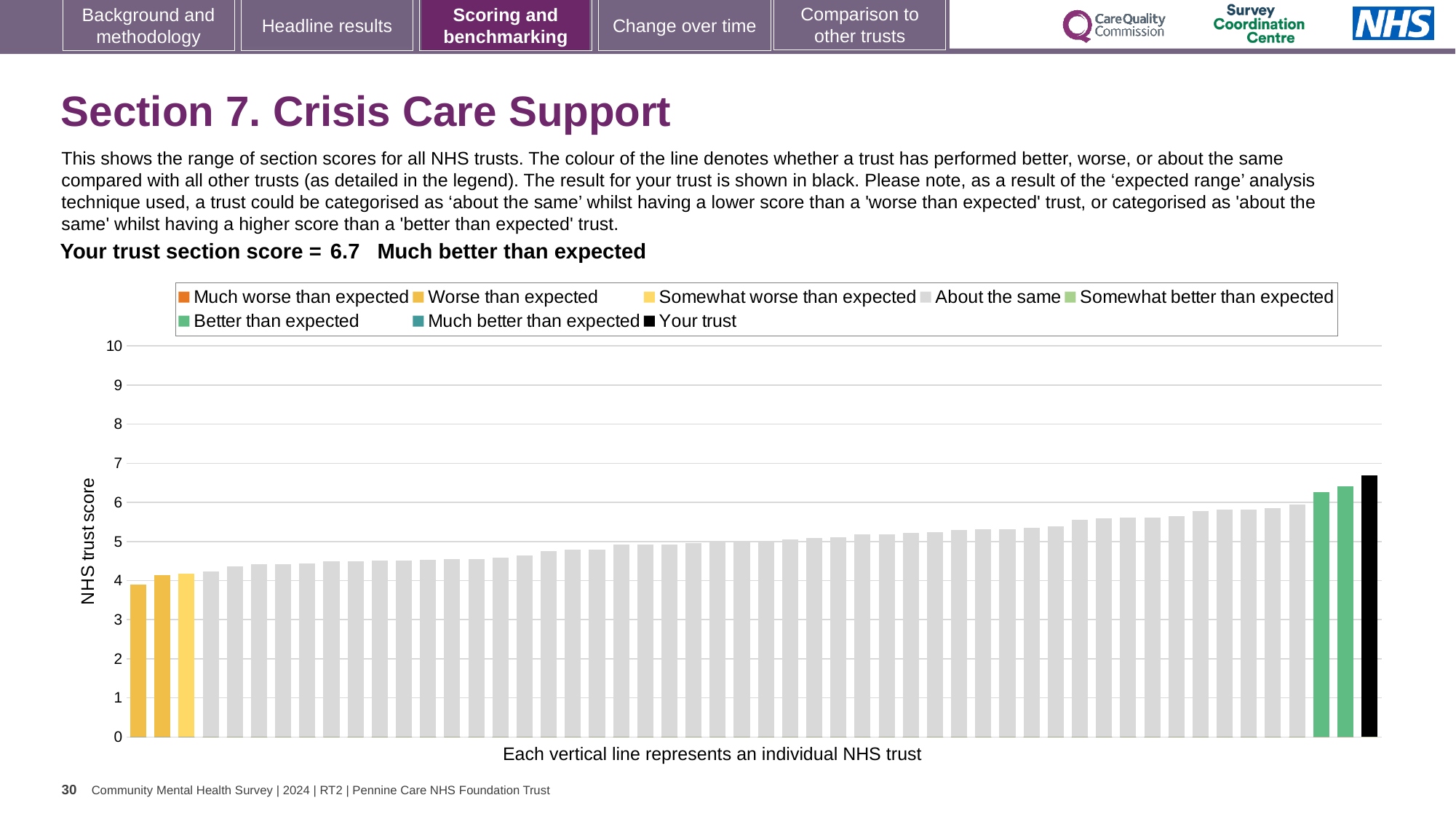
What is the section score for your trust shown on the slide? 6.7 Is the value of the black bar (your trust) greater or less than 6? greater Do the bar values rise or fall from left to right along the x axis? rise What colour represents 'Your trust' in the legend? black What kind of chart is shown on the slide? bar chart Which category does your trust's score fall into according to the slide? Much better than expected How many entries does the chart legend list? 8 What is the maximum value shown on the y axis? 10 Which bar is the highest on the chart: the black bar or the leftmost yellow bar? the black bar What is the label of the y axis? NHS trust score